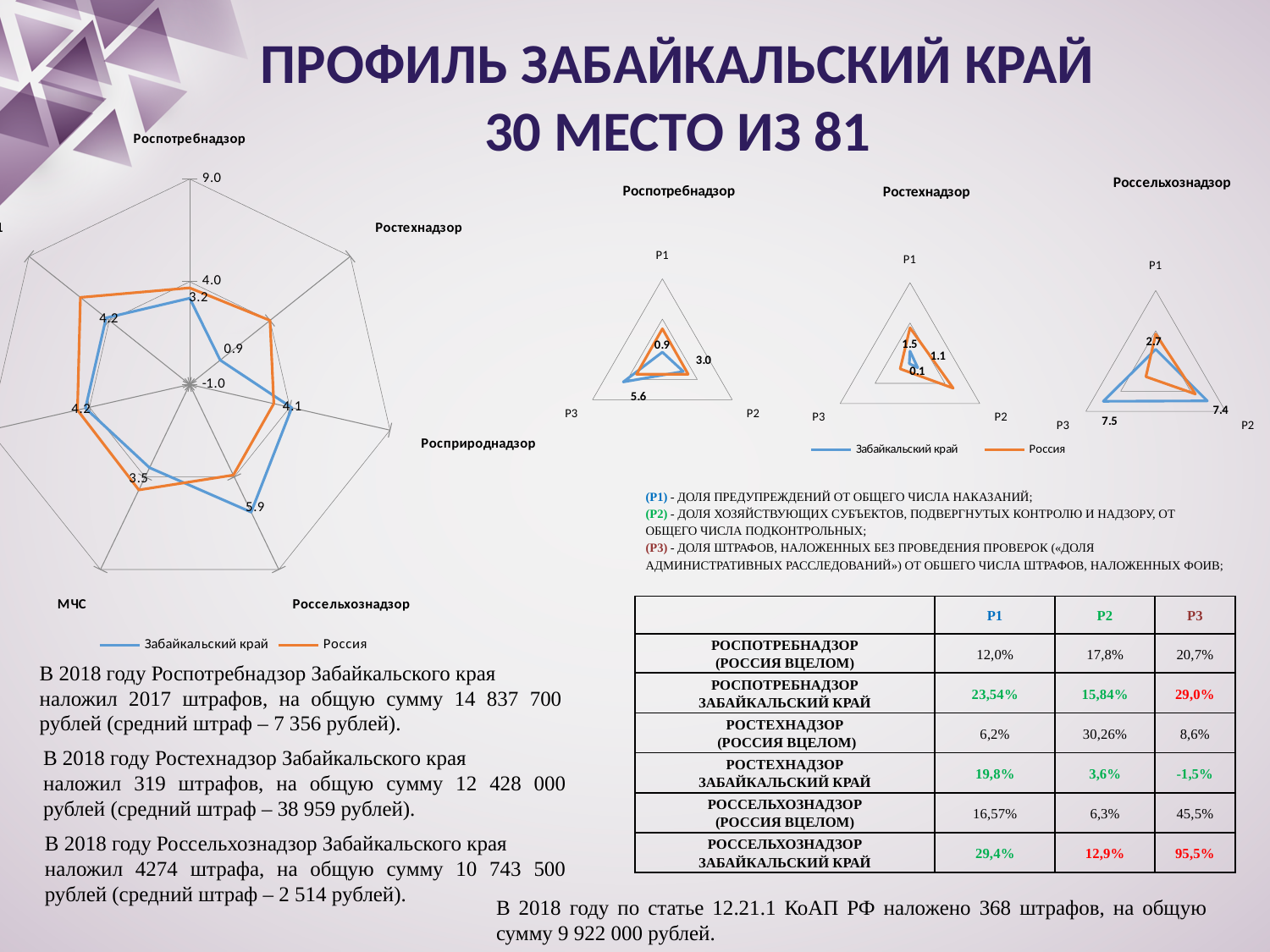
What is the highest axis tick value shown on the large radar chart on the left? 9.0 How many axes (P1, P2, P3) does the small Роспотребнадзор radar chart have? 3 On the small Ростехнадзор radar chart, what is the smallest data label printed? 0.1 What are the two legend entries of the large radar chart on the left? Забайкальский край, Россия What kind of chart is the large chart on the left of the slide? radar chart How many small radar charts are shown on the right side of the slide? 3 On the small Роспотребнадзор radar chart, what value is printed near the P3 axis? 5.6 How many series does the legend of the large radar chart on the left list? 2 On the small Россельхознадзор radar chart, is the value printed near P2 (7.4) larger or smaller than the value printed near P1 (2.7)? larger On the small Роспотребнадзор radar chart, what value is printed near the P2 axis? 3.0 On the small Россельхознадзор radar chart, what value is printed near the P3 axis? 7.5 On the small Россельхознадзор radar chart, what value is printed near the P1 axis? 2.7